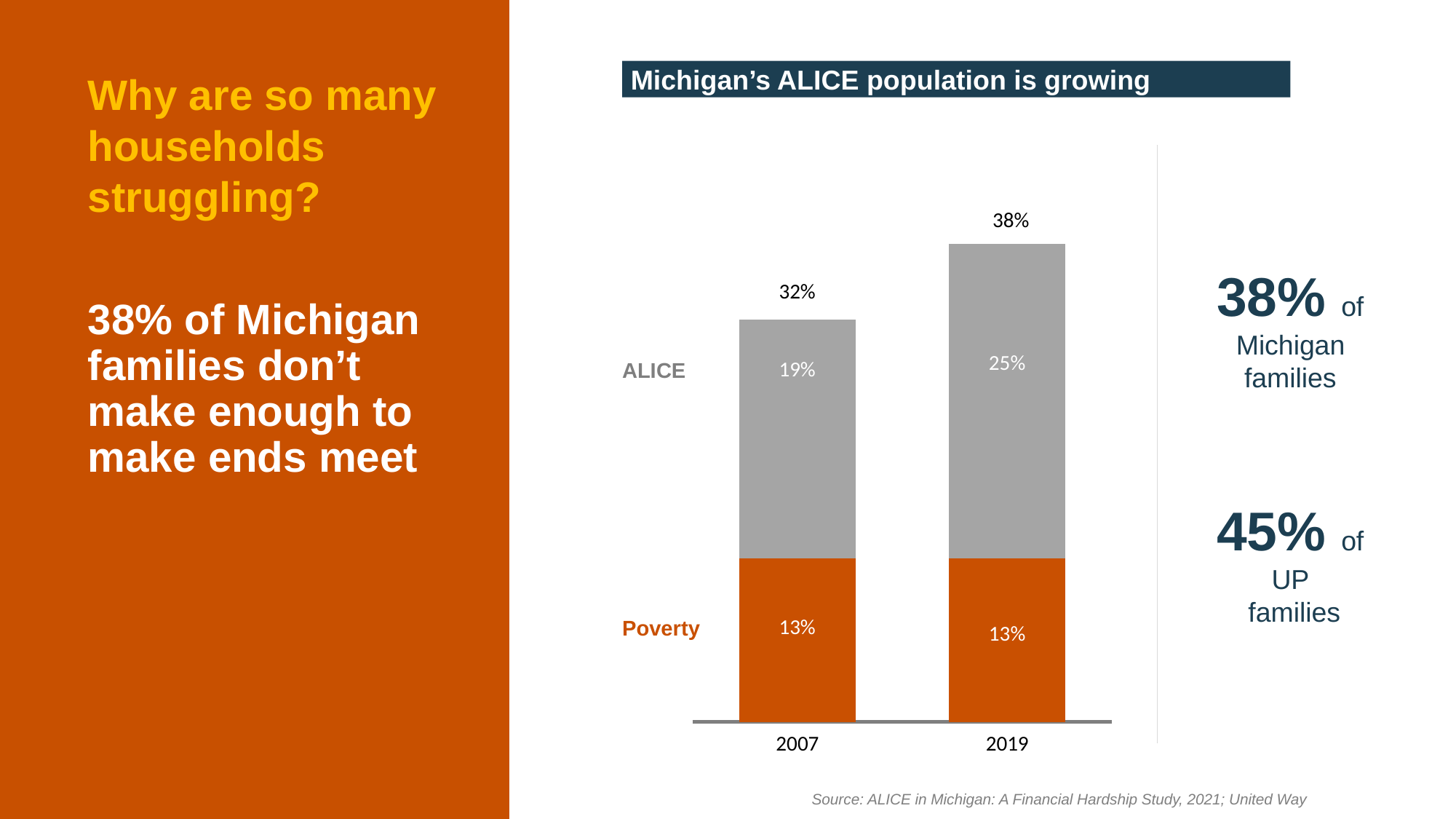
What is the ALICE value for 2019? 25% How many years are shown on the x axis? 2 What is the ALICE value for 2007? 19% What is the difference between the ALICE values for 2019 and 2007? 6% What kind of chart is shown? Stacked bar chart Which year has the higher total bar? 2019 What is the Poverty value for 2019? 13% What is the total of the stacked bar for 2007? 32% What is the title of the chart? Michigan's ALICE population is growing What is the difference between the stacked bar totals for 2019 and 2007? 6% What is the total of the stacked bar for 2019? 38% Which year has the higher ALICE value, 2007 or 2019? 2019